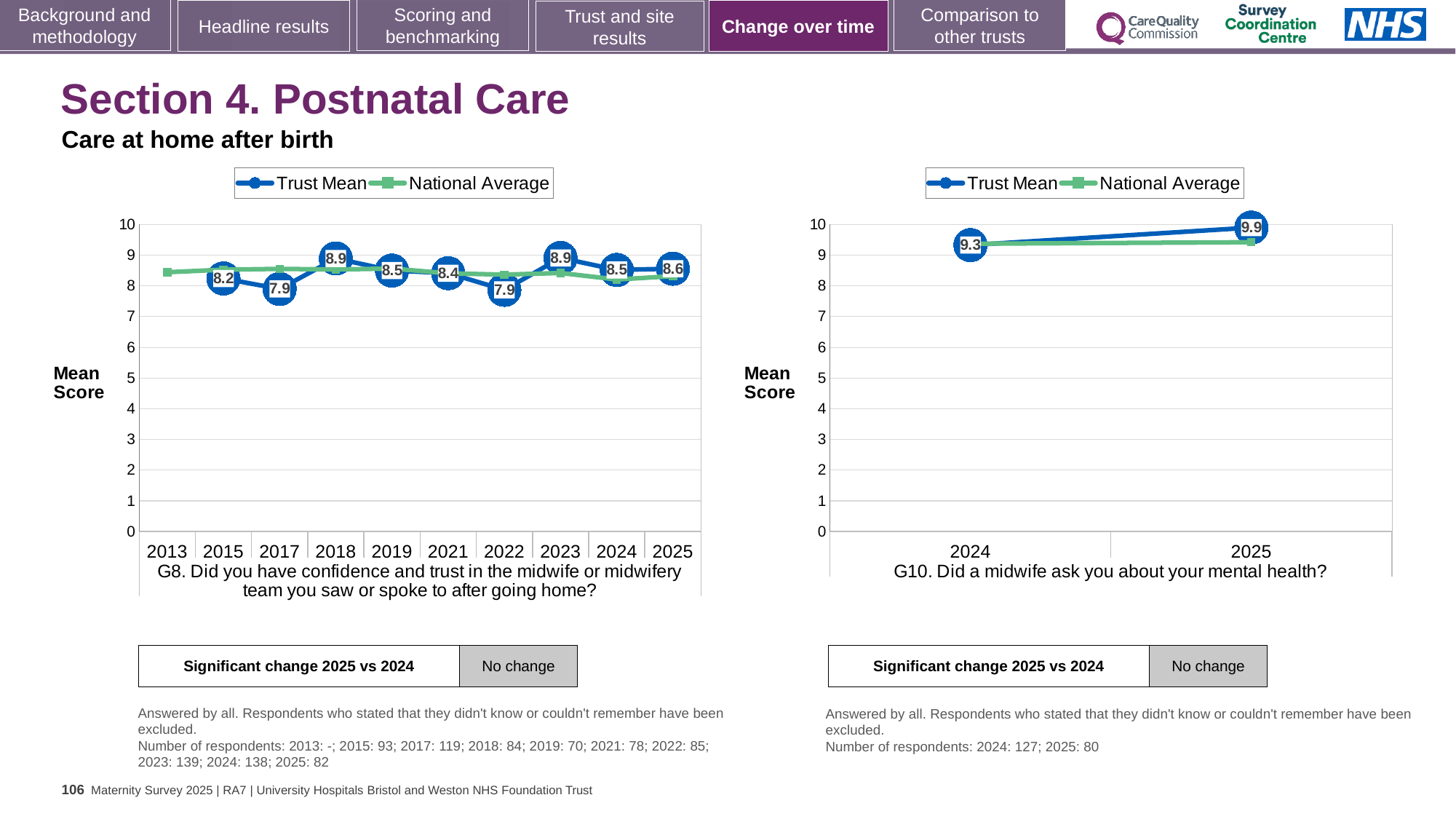
On the right chart (G10), does the Trust Mean rise or fall from 2024 to 2025? Rise On the left chart (G8), what is the Trust Mean for 2022? 7.9 On the left chart (G8), what is the difference between the Trust Mean for 2025 and 2024? 0.1 On the left chart (G8), is the National Average for 2013 greater or less than 8? greater On the left chart (G8), how many years are shown on the x axis? 10 On the right chart (G10), what is the difference between the Trust Mean for 2025 and 2024? 0.6 On the right chart (G10), what is the Trust Mean for 2024? 9.3 How many series does the legend of the left chart (G8) list? 2 On the left chart (G8), what is the Trust Mean for 2018? 8.9 On the left chart (G8), what is the Trust Mean for 2025? 8.6 What kind of chart is the right chart (G10)? Line chart On the left chart (G8), which year has the higher Trust Mean, 2017 or 2018? 2018